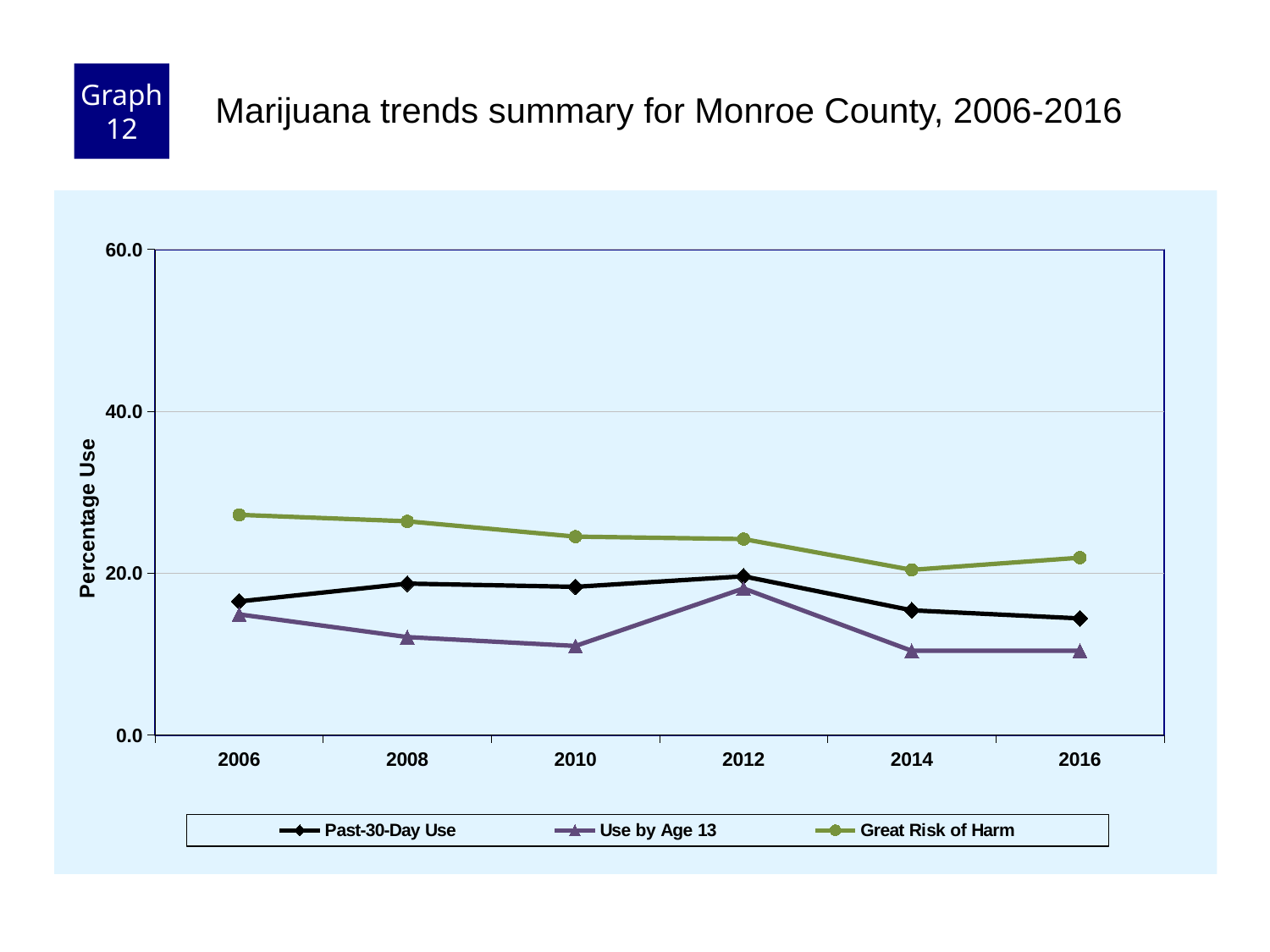
What is the label on the y axis? Percentage Use Is the value for Great Risk of Harm in 2010 greater or less than 40.0? less How many years are plotted along the x axis? 6 Is the value for Use by Age 13 in 2014 greater or less than 20.0? less What kind of chart is shown on the slide? line chart What is the title of the chart? Marijuana trends summary for Monroe County, 2006-2016 How many series does the legend list? 3 In which year is the Use by Age 13 series at its highest? 2012 Is the value for Great Risk of Harm in 2006 greater or less than 20.0? greater Does the Great Risk of Harm series rise or fall from 2006 to 2014? fall In 2014, which is larger: Past-30-Day Use or Use by Age 13? Past-30-Day Use